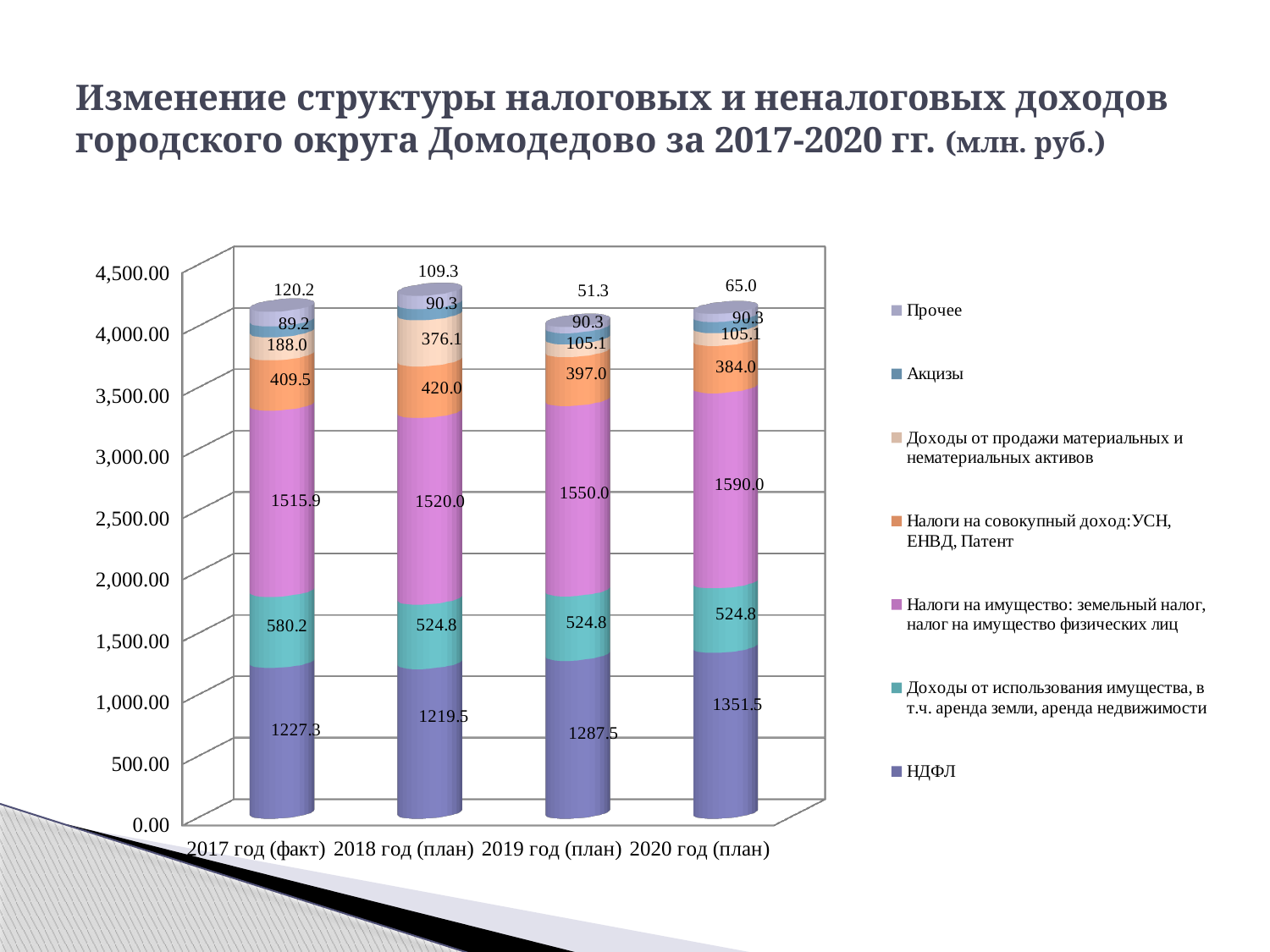
What is the value of НДФЛ for 2017 год (факт)? 1227.3 What is the value of Доходы от продажи материальных и нематериальных активов for 2018 год (план)? 376.1 In which year is the НДФЛ value the highest? 2020 год (план) What is the value of Прочее for 2019 год (план)? 51.3 What kind of chart is shown on the slide? Stacked bar chart Which is larger: Налоги на совокупный доход for 2018 год (план) or for 2019 год (план)? 2018 год (план) Do the Налоги на имущество values rise or fall from 2017 to 2020? Rise How many series does the legend list? 7 How many categories (years) are shown on the x axis? 4 In which year is the Прочее value the lowest? 2019 год (план) What is the value of Налоги на имущество for 2020 год (план)? 1590.0 What is the difference between the НДФЛ values for 2020 год (план) and 2017 год (факт)? 124.2